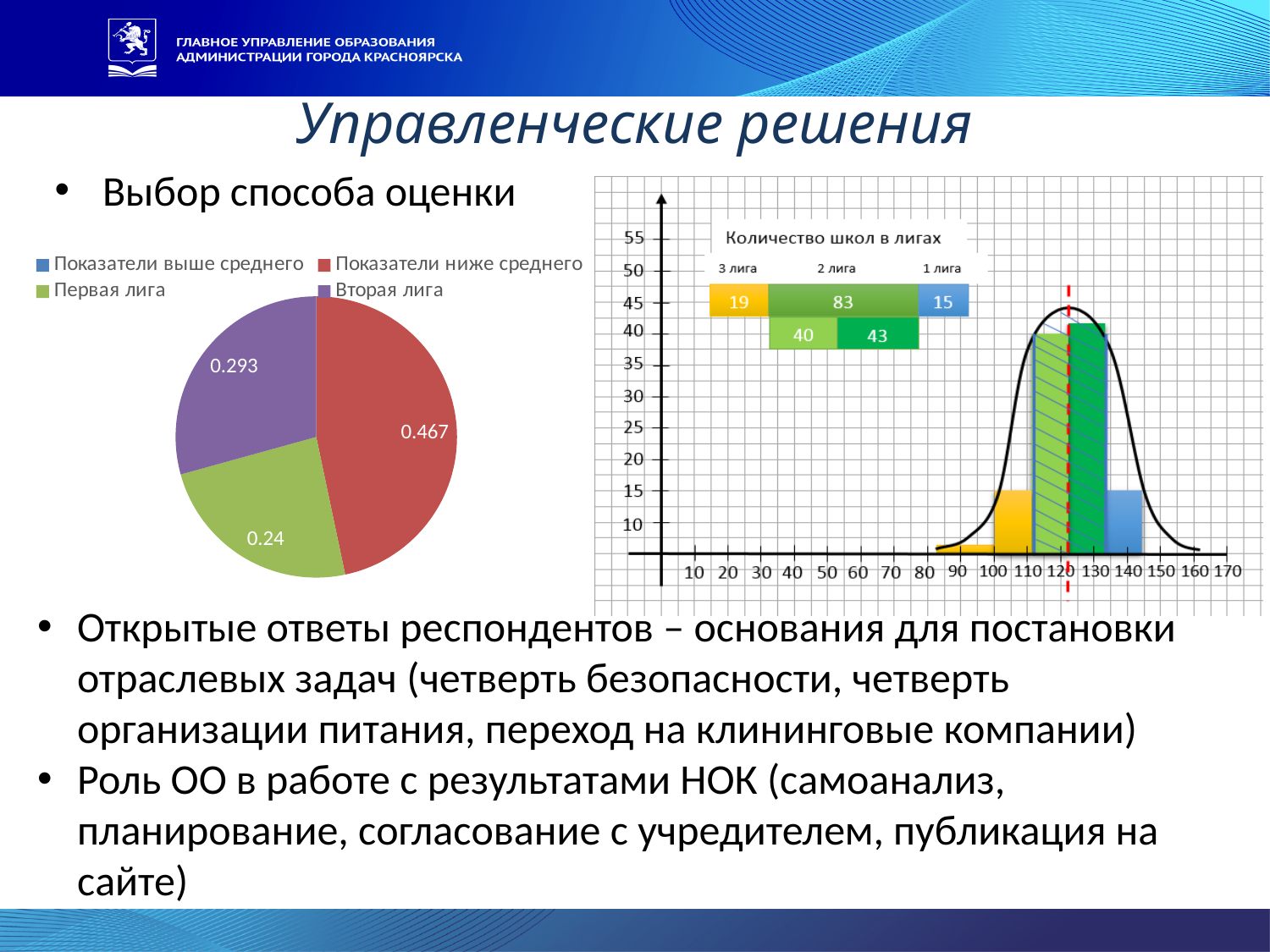
On the pie chart on the left, which slice has the largest value? Показатели ниже среднего On the pie chart on the left, which is larger: the value for "Вторая лига" or the value for "Первая лига"? Вторая лига What type of chart is shown on the left of the slide? Pie chart On the pie chart on the left, what is the difference between the values for "Показатели ниже среднего" and "Вторая лига"? 0.174 On the pie chart on the left, what value is shown for the slice labelled "Вторая лига"? 0.293 On the pie chart on the left, what value is shown for the slice labelled "Показатели ниже среднего"? 0.467 On the pie chart on the left, what value is shown for the slice labelled "Первая лига"? 0.24 On the pie chart on the left, what colour is the slice labelled "Показатели ниже среднего"? Red On the chart on the right titled "Количество школ в лигах", how many schools are shown for "2 лига"? 83 How many entries does the legend of the pie chart on the left list? 4 On the pie chart on the left, which of the labelled slices has the smallest value? Первая лига On the chart on the right titled "Количество школ в лигах", how many schools are shown for "1 лига"? 15